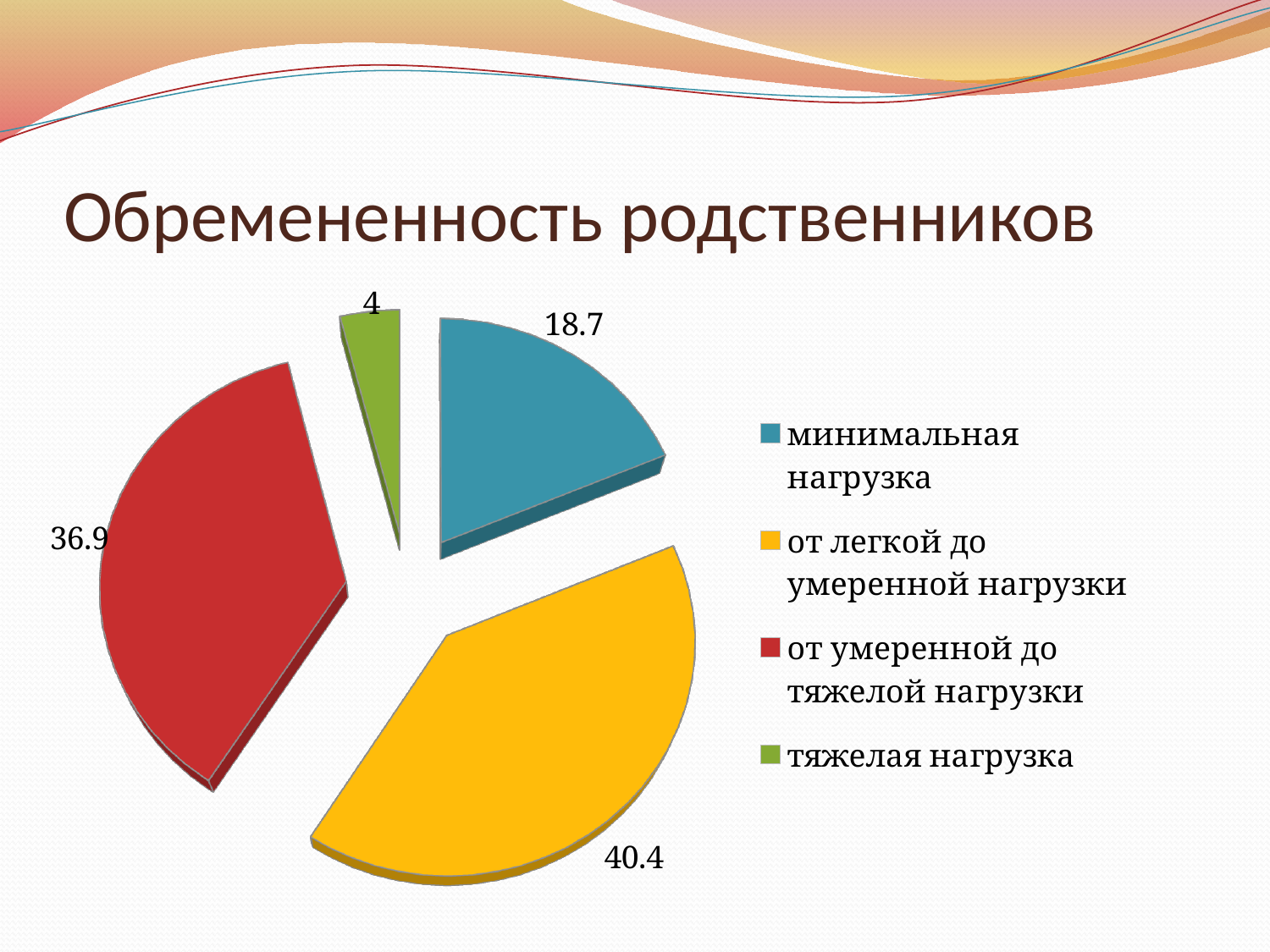
What is the value for "минимальная нагрузка"? 18.7 What is the difference between the values for "минимальная нагрузка" and "тяжелая нагрузка"? 14.7 What is the title of the chart on the slide? Обремененность родственников What is the value for "тяжелая нагрузка"? 4 Which category has the largest slice of the pie? от легкой до умеренной нагрузки Which is larger: the value for "минимальная нагрузка" or the value for "от умеренной до тяжелой нагрузки"? от умеренной до тяжелой нагрузки What is the value for "от умеренной до тяжелой нагрузки"? 36.9 Which category has the smallest slice of the pie? тяжелая нагрузка What kind of chart is shown on the slide? pie chart What is the value for "от легкой до умеренной нагрузки"? 40.4 How many categories does the pie chart have? 4 What is the difference between the values for "от легкой до умеренной нагрузки" and "от умеренной до тяжелой нагрузки"? 3.5